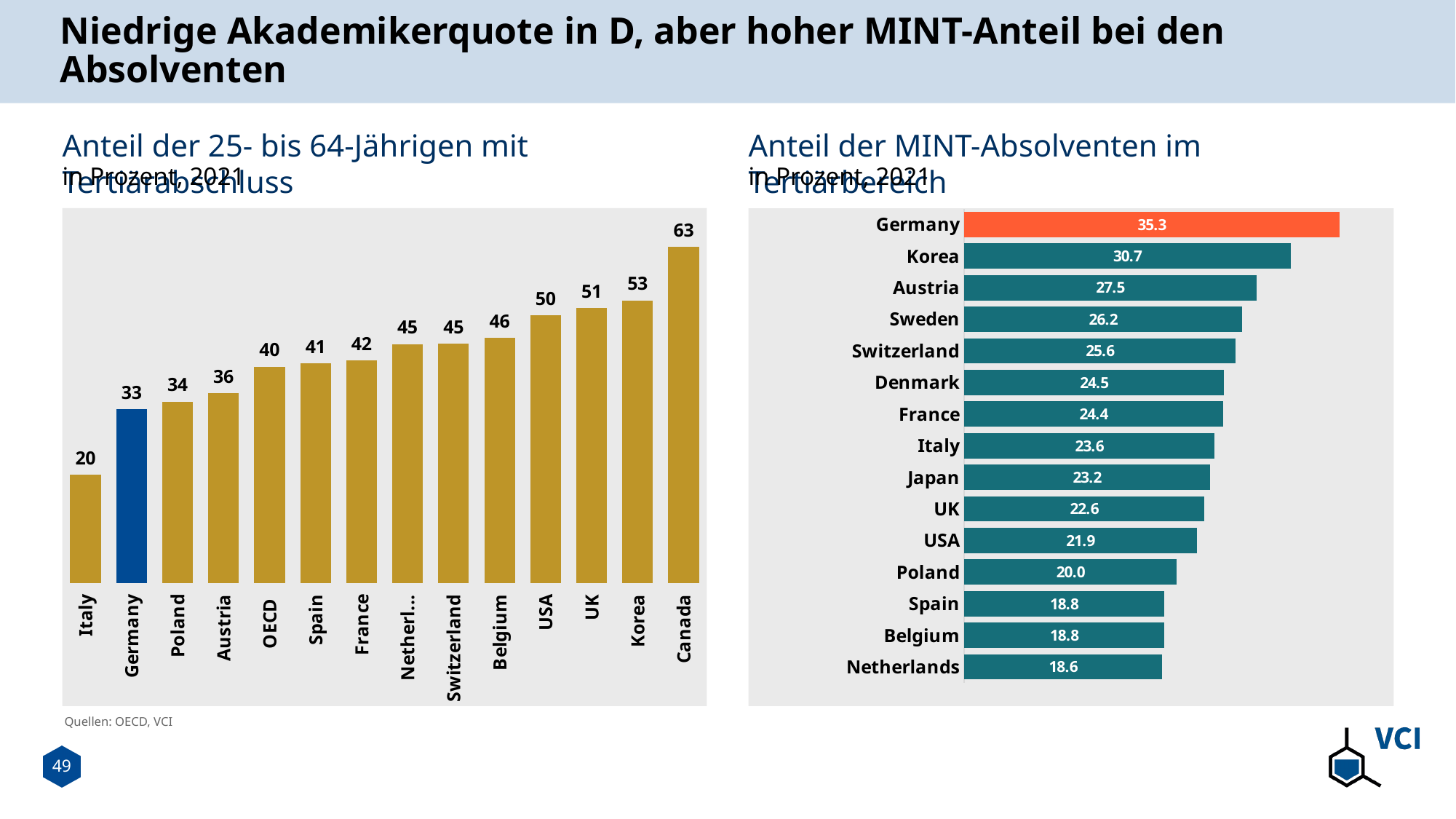
In the right chart (Anteil der MINT-Absolventen im Tertiärbereich), what is the value for Germany? 35.3 In the left chart (Anteil der 25- bis 64-Jährigen mit Tertiärabschluss), which country has the lowest value? Italy In the left chart (Anteil der 25- bis 64-Jährigen mit Tertiärabschluss), what is the value for Germany? 33 In the right chart (Anteil der MINT-Absolventen im Tertiärbereich), which country has the lowest value? Netherlands In the left chart (Anteil der 25- bis 64-Jährigen mit Tertiärabschluss), what is the difference between Canada and Germany? 30 In the left chart (Anteil der 25- bis 64-Jährigen mit Tertiärabschluss), what is the value for the OECD? 40 In the right chart (Anteil der MINT-Absolventen im Tertiärbereich), how many countries are listed? 15 In the left chart (Anteil der 25- bis 64-Jährigen mit Tertiärabschluss), how many bars are shown? 14 In the left chart (Anteil der 25- bis 64-Jährigen mit Tertiärabschluss), which country has the highest value? Canada In the right chart (Anteil der MINT-Absolventen im Tertiärbereich), what is the difference between Germany and Korea? 4.6 What type of chart is the right chart (Anteil der MINT-Absolventen im Tertiärbereich)? Bar chart In the right chart (Anteil der MINT-Absolventen im Tertiärbereich), which is larger, Korea or Austria? Korea